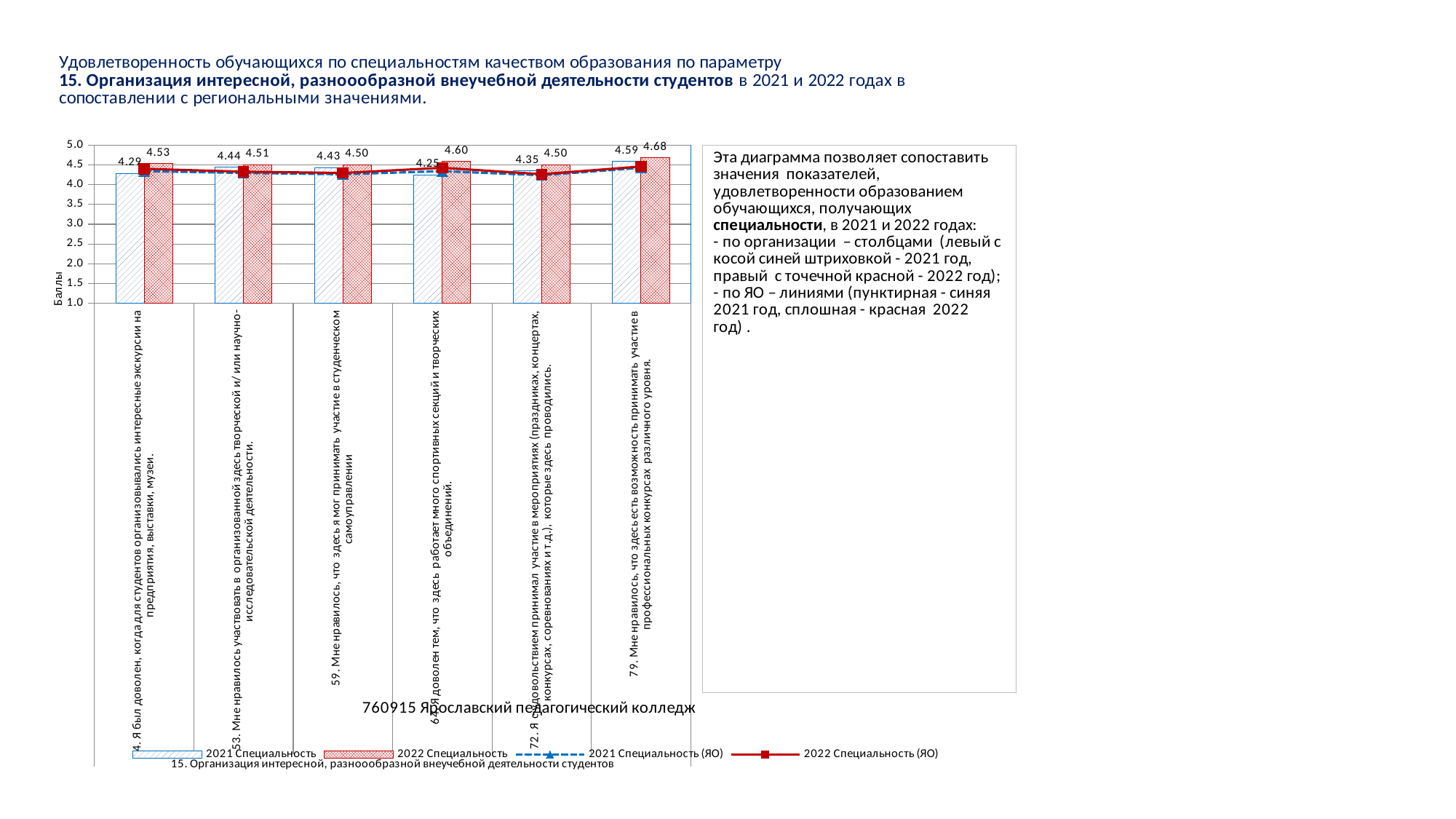
What is the difference between the 2022 and 2021 Специальность values for item 64? 0.35 How many items (categories) are shown on the x axis of the chart? 6 What is the 2021 Специальность value for item 4 (экскурсии на предприятия, выставки, музеи)? 4.29 What is the 2022 Специальность value for item 79 (профессиональных конкурсах различного уровня)? 4.68 What is the label of the vertical axis of the chart? Баллы Which item has the lowest 2021 Специальность value? 64. Я доволен тем, что здесь работает много спортивных секций и творческих объединений. What is the 2021 Специальность value for item 72 (мероприятиях: праздниках, концертах, конкурсах)? 4.35 Which item has the highest 2022 Специальность value? 79. Мне нравилось, что здесь есть возможность принимать участие в профессиональных конкурсах различного уровня. What is the 2022 Специальность value for item 64 (спортивных секций и творческих объединений)? 4.60 Which is larger for item 53: the 2021 Специальность value or the 2022 Специальность value? 2022 Специальность (4.51) What type of chart is shown on the slide? Combined bar and line chart How many series does the chart legend list? 4